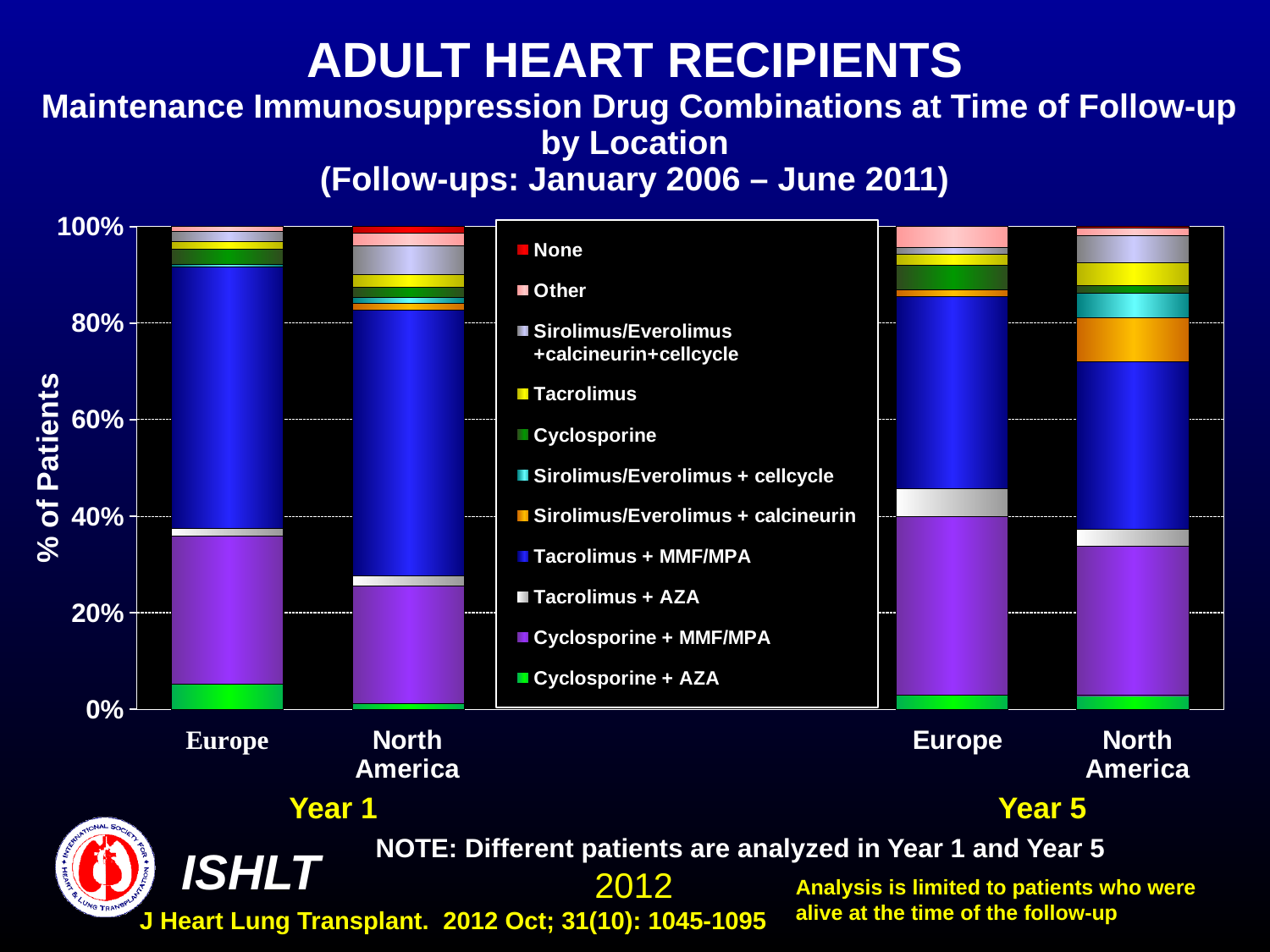
In the Year 5 North America bar, is the top of the Tacrolimus + MMF/MPA segment greater or less than 80%? less In the Year 1 Europe bar, is the top of the Tacrolimus + MMF/MPA segment greater or less than 80%? greater In the Year 5 Europe bar, is the top of the Tacrolimus + MMF/MPA segment greater or less than 80%? greater How many drug combination series does the legend list? 11 What kind of chart is shown on the slide? Stacked bar chart How many bars are plotted in the chart? 4 For North America, does the Sirolimus/Everolimus + calcineurin segment increase or decrease from Year 1 to Year 5? increase What follow-up period is stated in the chart title? January 2006 – June 2011 In Year 1, which location has the larger Cyclosporine + AZA segment, Europe or North America? Europe In Year 5, which location has the larger Sirolimus/Everolimus + calcineurin segment, Europe or North America? North America What is the label of the y axis? % of Patients